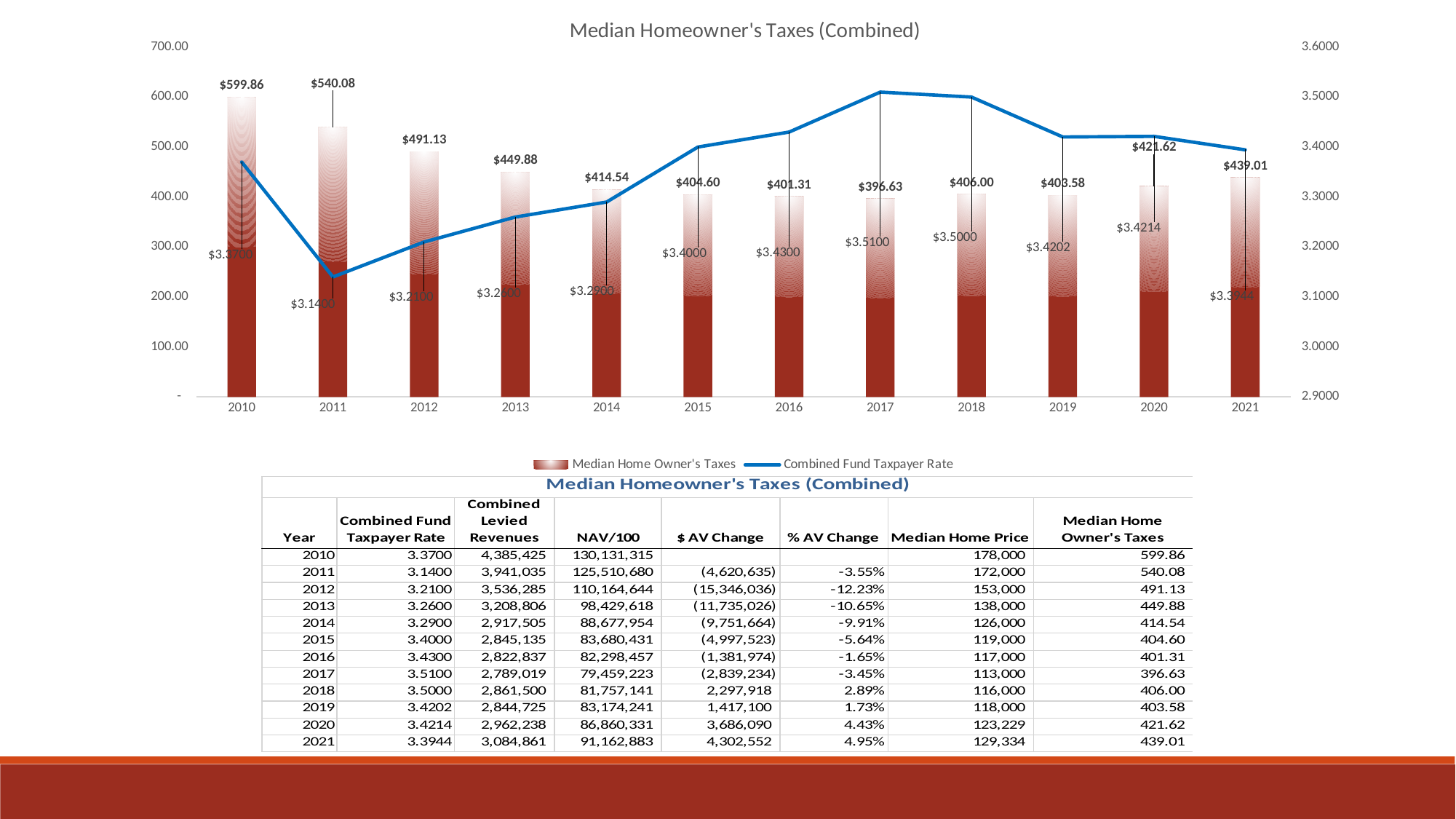
Which year has the lowest Combined Fund Taxpayer Rate? 2011 What is the difference between the Median Home Owner's Taxes in 2010 and 2011? $59.78 Which is larger, the Median Home Owner's Taxes in 2020 or in 2019? 2020 Which year has the lowest Median Home Owner's Taxes? 2017 How many series does the legend list? 2 What is the Median Home Owner's Taxes value for 2021? $439.01 What is the Median Home Owner's Taxes value for 2010? $599.86 What kind of chart is this? Combined bar and line chart What is the Combined Fund Taxpayer Rate shown for 2017? $3.5100 How many years are plotted on the x axis? 12 What is the title of the chart? Median Homeowner's Taxes (Combined) Which year has the highest Median Home Owner's Taxes? 2010